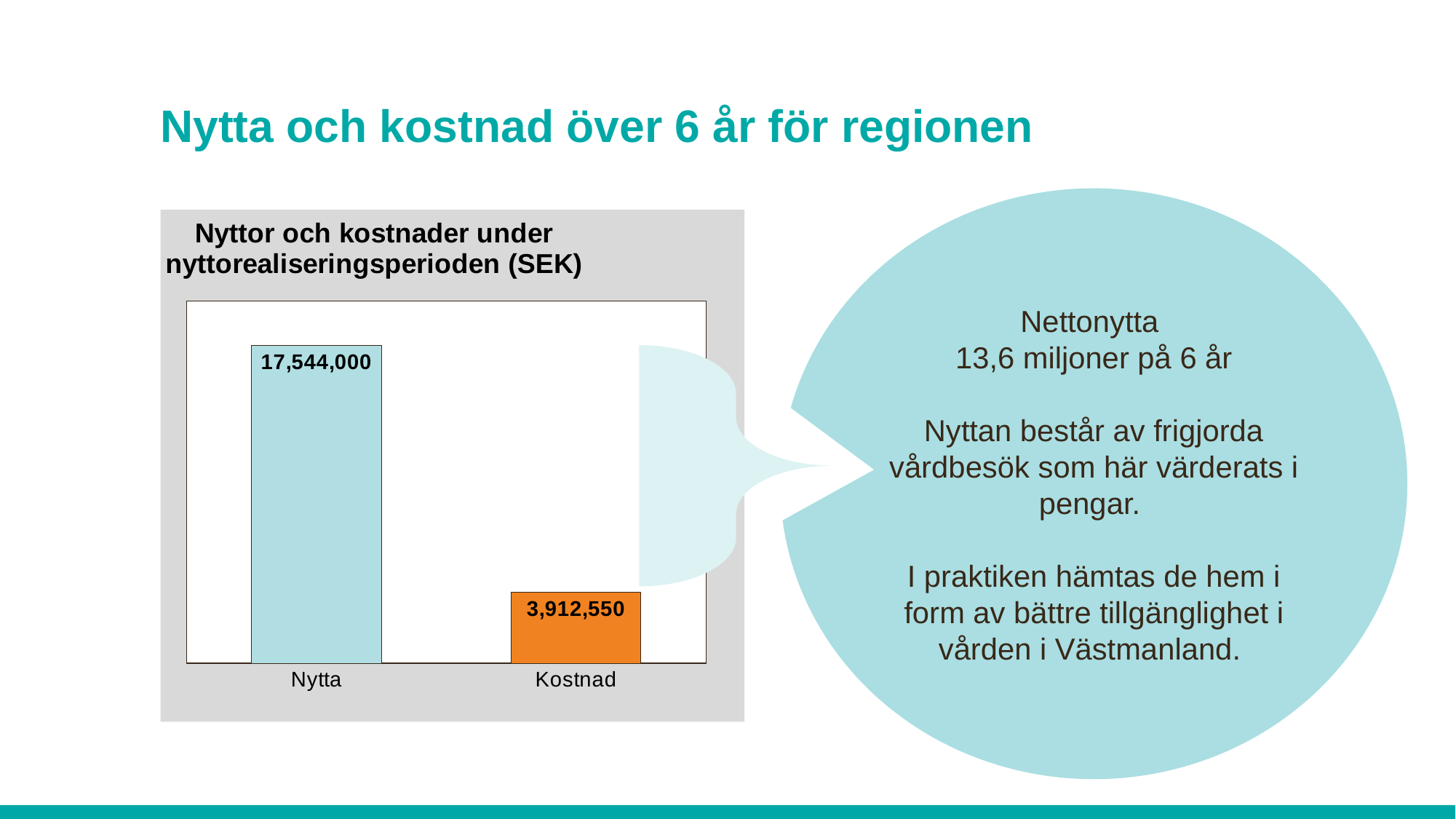
Which category has the highest value? Nytta What colour is the bar for Kostnad? Orange What is the value for Kostnad? 3,912,550 What is the difference between the values for Nytta and Kostnad? 13,631,450 Which is larger, the value for Nytta or the value for Kostnad? Nytta What is the title of the chart? Nyttor och kostnader under nyttorealiseringsperioden (SEK) How many categories are shown in the chart? 2 What is the value for Nytta? 17,544,000 Which category has the lowest value? Kostnad What kind of chart is shown on the slide? Bar chart